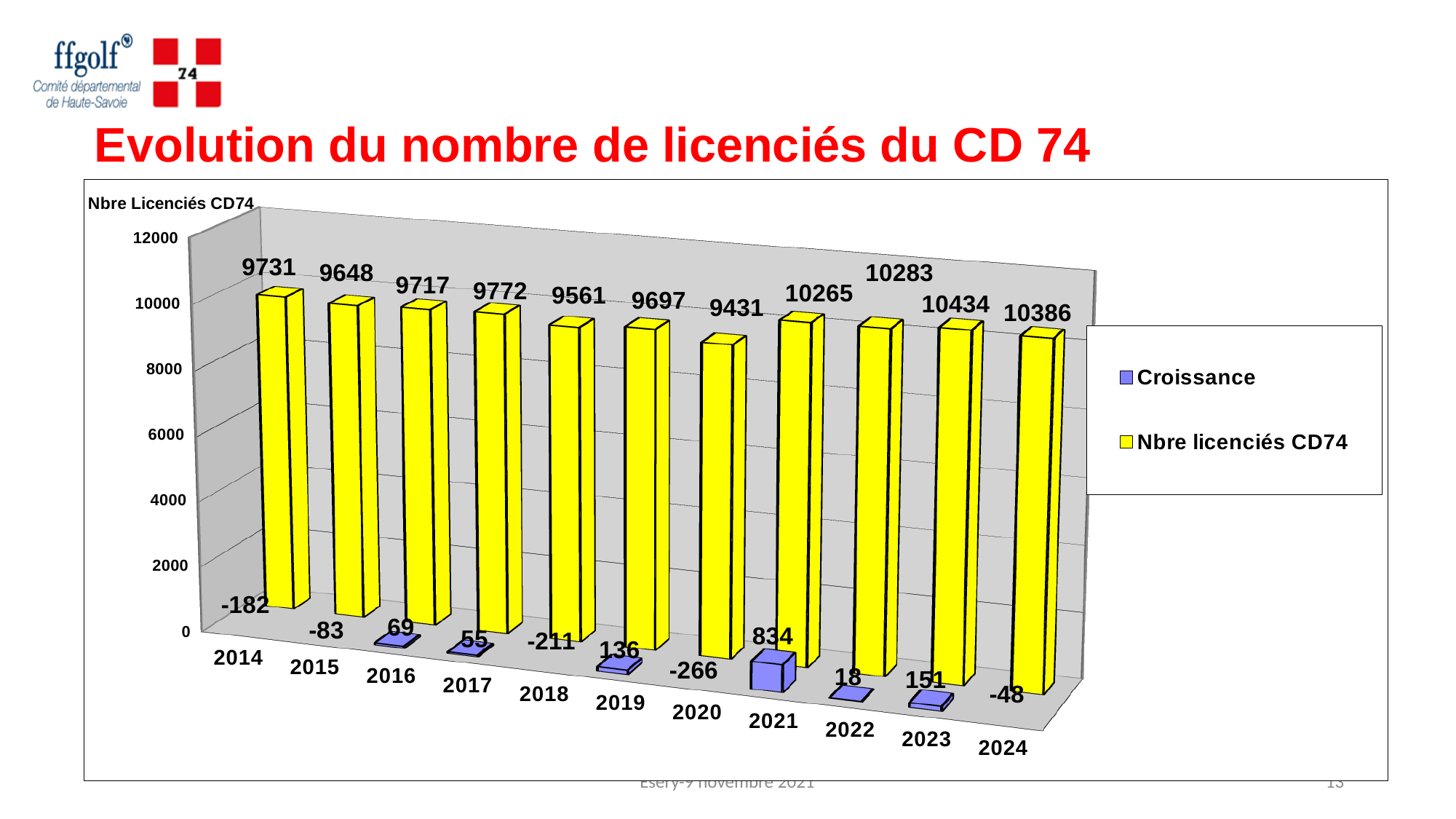
How many series does the legend list? 2 Which is larger, the Nbre licenciés CD74 value for 2017 or for 2019? 2017 What is the Croissance value for 2018? -211 What is the value of Nbre licenciés CD74 for 2020? 9431 Which year has the lowest value of Nbre licenciés CD74? 2020 What is the Croissance value for 2021? 834 What is the value of Nbre licenciés CD74 for 2014? 9731 What kind of chart is shown on the slide? Bar chart What is the difference between the Nbre licenciés CD74 values for 2023 and 2024? 48 Which year has the highest value of Nbre licenciés CD74? 2023 How many years are shown on the x axis? 11 Which year has the lowest Croissance value? 2020